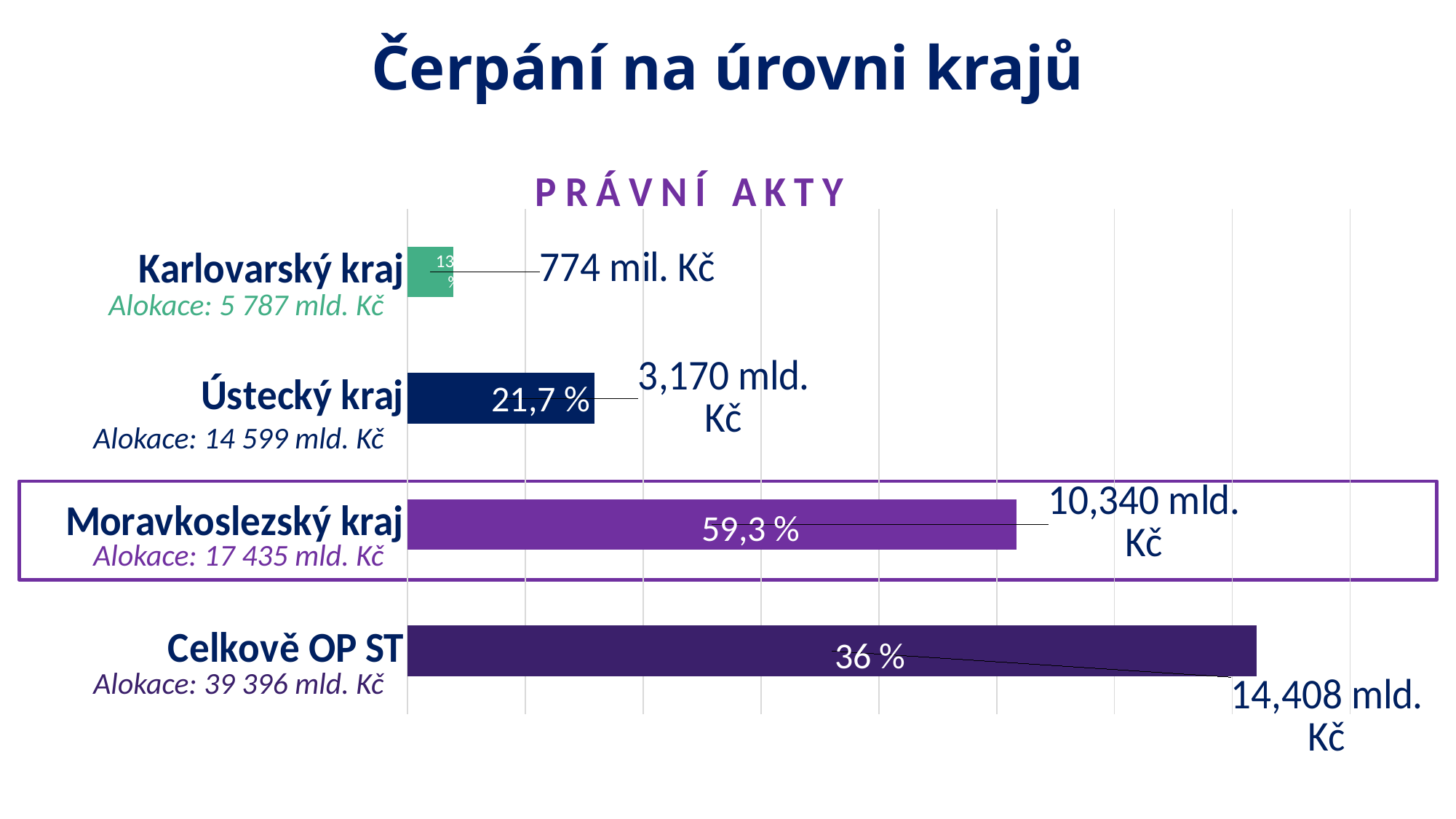
What percentage is shown on the bar for Celkově OP ST? 36 % What amount in Kč is labelled next to the bar for Moravkoslezský kraj? 10,340 mld. Kč What percentage is shown on the bar for Moravkoslezský kraj? 59,3 % Which category has the shortest bar (lowest percentage)? Karlovarský kraj What amount in Kč is labelled next to the bar for Celkově OP ST? 14,408 mld. Kč What is the difference in percentage points between Moravkoslezský kraj (59,3 %) and Ústecký kraj (21,7 %)? 37,6 % How many categories (bars) does the chart show? 4 What percentage is shown on the bar for Ústecký kraj? 21,7 % What type of chart is shown on the slide? Bar chart Which has a higher percentage, Ústecký kraj or Celkově OP ST? Celkově OP ST What amount in Kč is labelled next to the bar for Karlovarský kraj? 774 mil. Kč